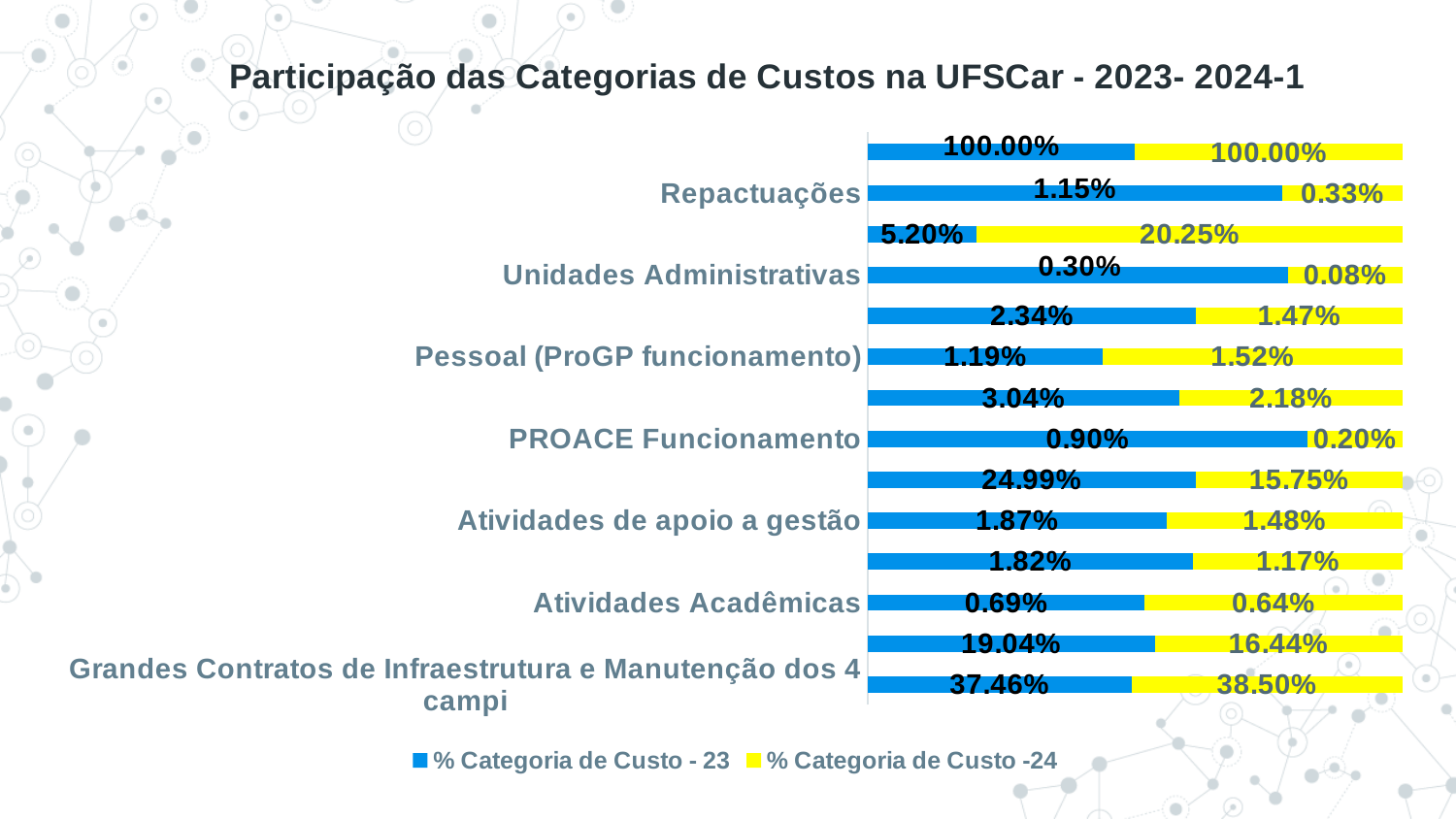
What is the % Categoria de Custo - 23 value for PROACE Funcionamento? 0.90% What is the % Categoria de Custo -24 value for Repactuações? 0.33% What is the % Categoria de Custo -24 value for Atividades Acadêmicas? 0.64% How many series does the legend list? 2 What is the title of the chart? Participação das Categorias de Custos na UFSCar - 2023- 2024-1 For Grandes Contratos de Infraestrutura e Manutenção dos 4 campi, which series has the larger value, % Categoria de Custo - 23 or % Categoria de Custo -24? % Categoria de Custo -24 What is the % Categoria de Custo - 23 value for Grandes Contratos de Infraestrutura e Manutenção dos 4 campi? 37.46% What is the difference between the % Categoria de Custo -24 and % Categoria de Custo - 23 values for Grandes Contratos de Infraestrutura e Manutenção dos 4 campi? 1.04 percentage points What is the % Categoria de Custo - 23 value for Repactuações? 1.15% What is the % Categoria de Custo -24 value for Grandes Contratos de Infraestrutura e Manutenção dos 4 campi? 38.50% What kind of chart is shown on the slide? bar chart What are the two series named in the legend? % Categoria de Custo - 23 and % Categoria de Custo -24